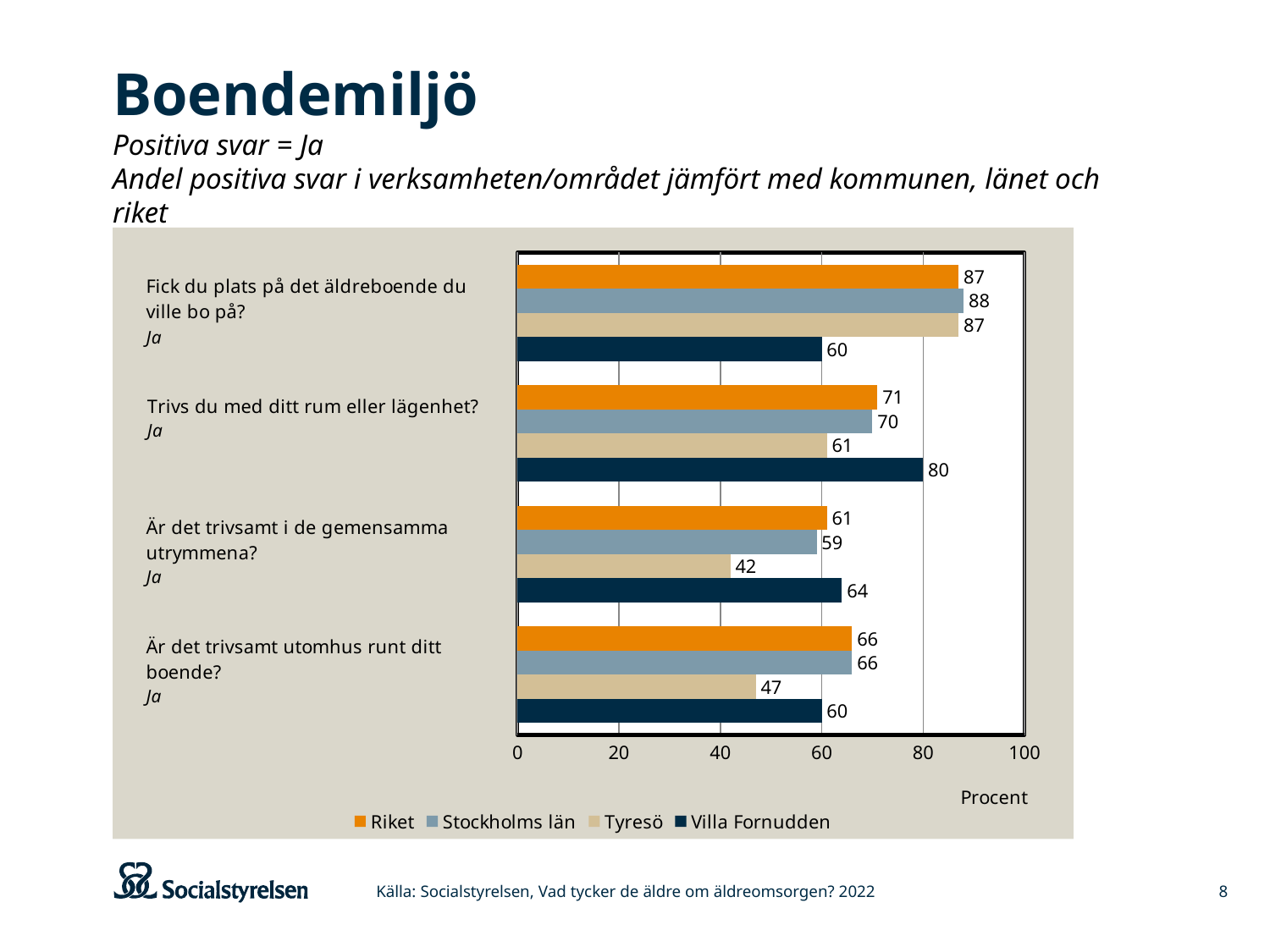
How many series does the legend list? 4 What kind of chart is shown on the slide? Bar chart What is the value for Riket on "Är det trivsamt utomhus runt ditt boende?"? 66 How many questions (categories) are shown on the chart? 4 What is the difference between Villa Fornudden and Tyresö on "Trivs du med ditt rum eller lägenhet?"? 19 What is the value for Villa Fornudden on "Trivs du med ditt rum eller lägenhet?"? 80 Which series has the highest value on "Är det trivsamt i de gemensamma utrymmena?"? Villa Fornudden What unit is shown on the x axis of the chart? Procent Which is larger on "Är det trivsamt utomhus runt ditt boende?": Tyresö or Villa Fornudden? Villa Fornudden Which series has the lowest value on "Fick du plats på det äldreboende du ville bo på?"? Villa Fornudden What is the value for Stockholms län on "Fick du plats på det äldreboende du ville bo på?"? 88 What is the value for Tyresö on "Är det trivsamt i de gemensamma utrymmena?"? 42